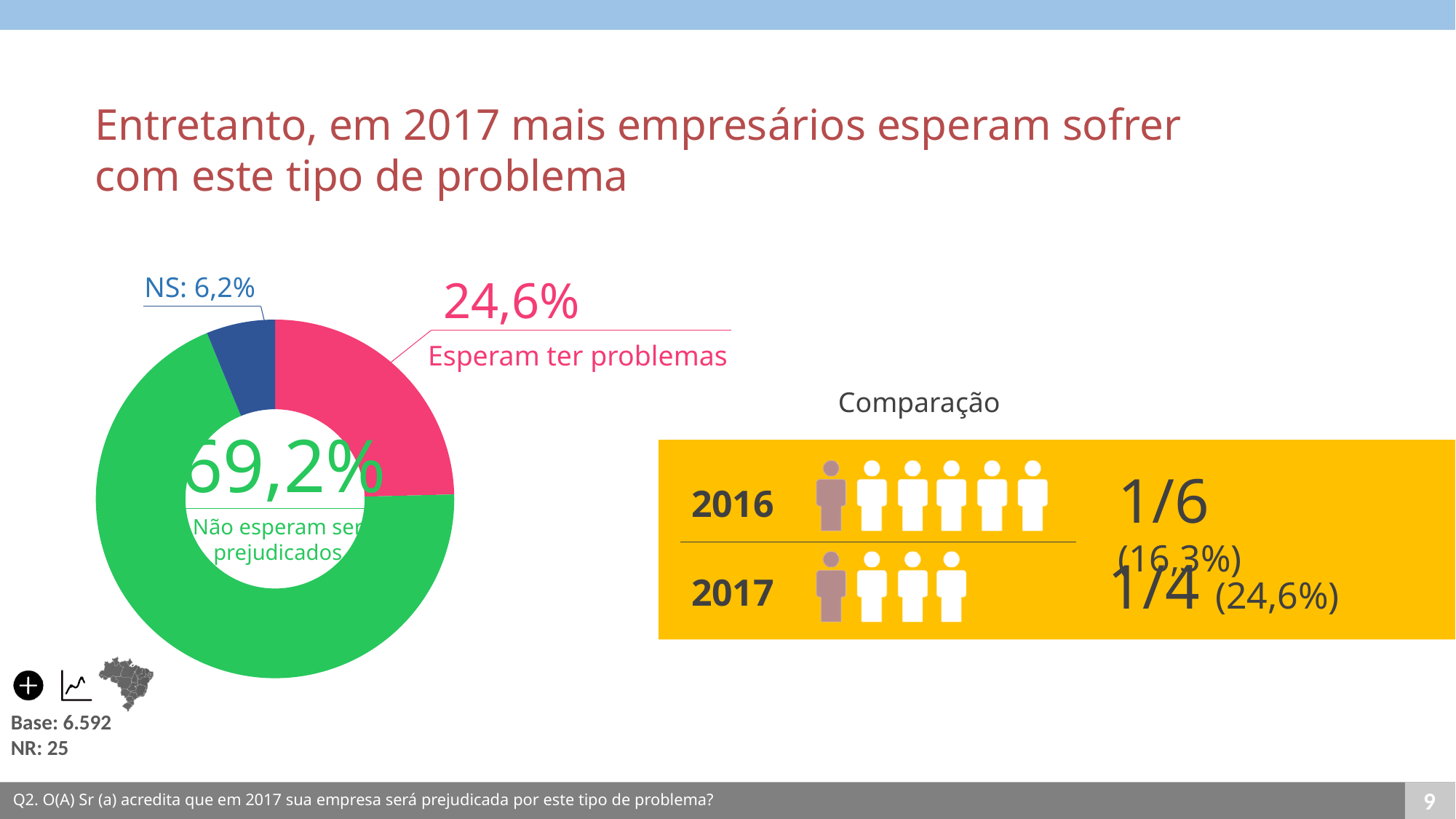
What colour is the 'Esperam ter problemas' slice in the donut chart? Pink Which is larger in the donut chart: 'Esperam ter problemas' or NS? Esperam ter problemas Which slice of the donut chart is the smallest? NS In the donut chart, what share of respondents 'Não esperam ser prejudicados'? 69,2% What is the difference between the 'Não esperam ser prejudicados' share and the 'Esperam ter problemas' share in the donut chart? 44,6 percentage points In the 'Comparação' panel, what percentage is shown for 2016? 16,3% In the 'Comparação' panel, what fraction is shown for 2017? 1/4 What kind of chart is shown on the left of the slide? Donut (pie) chart In the donut chart, what is the value of the NS slice? 6,2% In the donut chart, what share of respondents 'Esperam ter problemas'? 24,6% How many slices does the donut chart have? 3 Which slice of the donut chart is the largest? Não esperam ser prejudicados